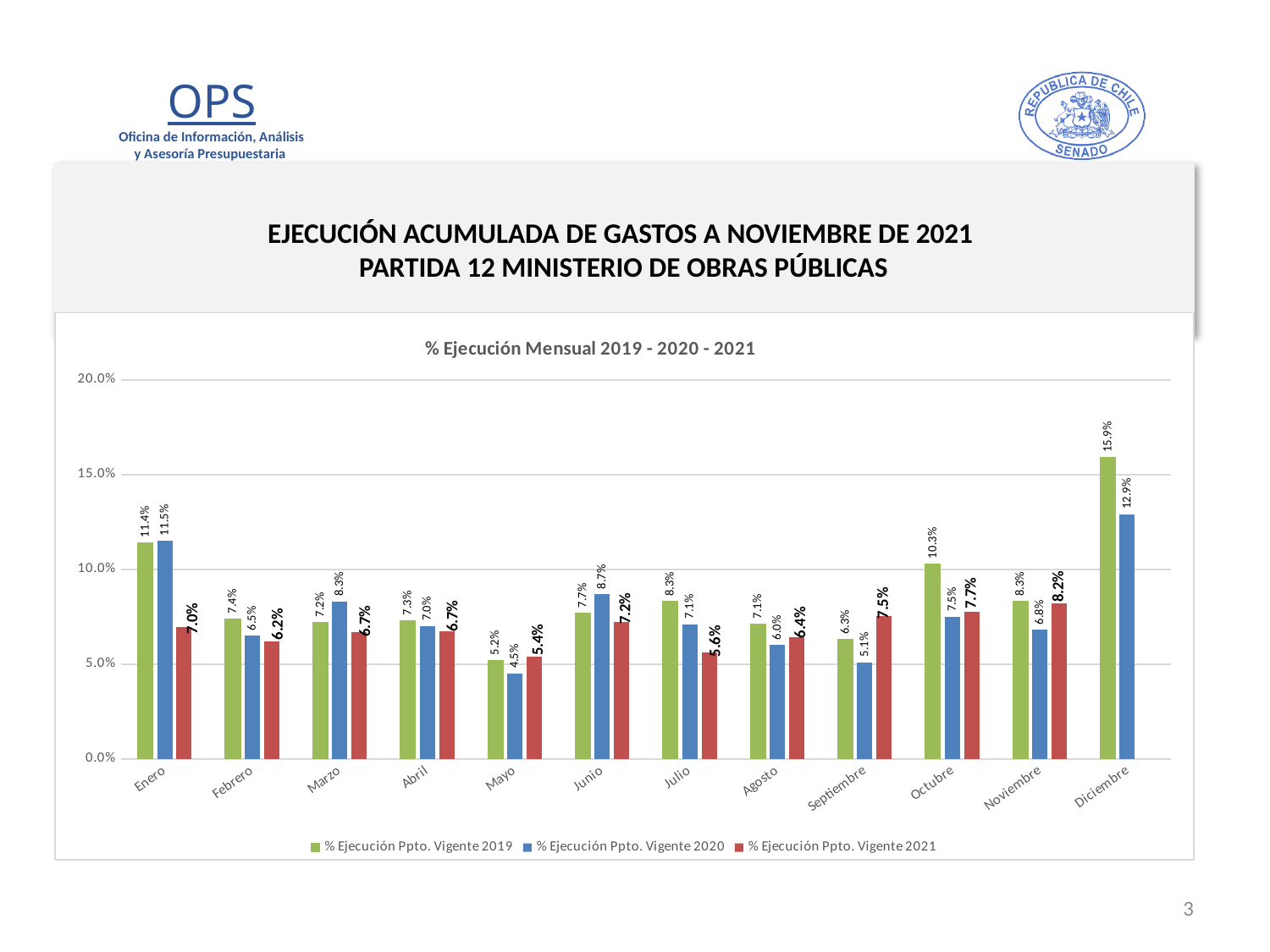
Which month has the lowest value for % Ejecución Ppto. Vigente 2020? Mayo What kind of chart is shown on the slide? Bar chart What is the difference between the 2019 and 2020 values in Diciembre? 3.0% What is the value for % Ejecución Ppto. Vigente 2019 in Diciembre? 15.9% Which month has the highest value for % Ejecución Ppto. Vigente 2021? Noviembre How many series does the legend list? 3 Is the value for % Ejecución Ppto. Vigente 2019 in Octubre greater or less than 10.0%? greater How many months are shown on the x axis? 12 What is the title of the chart? % Ejecución Mensual 2019 - 2020 - 2021 What is the value for % Ejecución Ppto. Vigente 2021 in Enero? 7.0% In Septiembre, which series has the larger value: % Ejecución Ppto. Vigente 2019 or % Ejecución Ppto. Vigente 2021? % Ejecución Ppto. Vigente 2021 What is the value for % Ejecución Ppto. Vigente 2020 in Junio? 8.7%